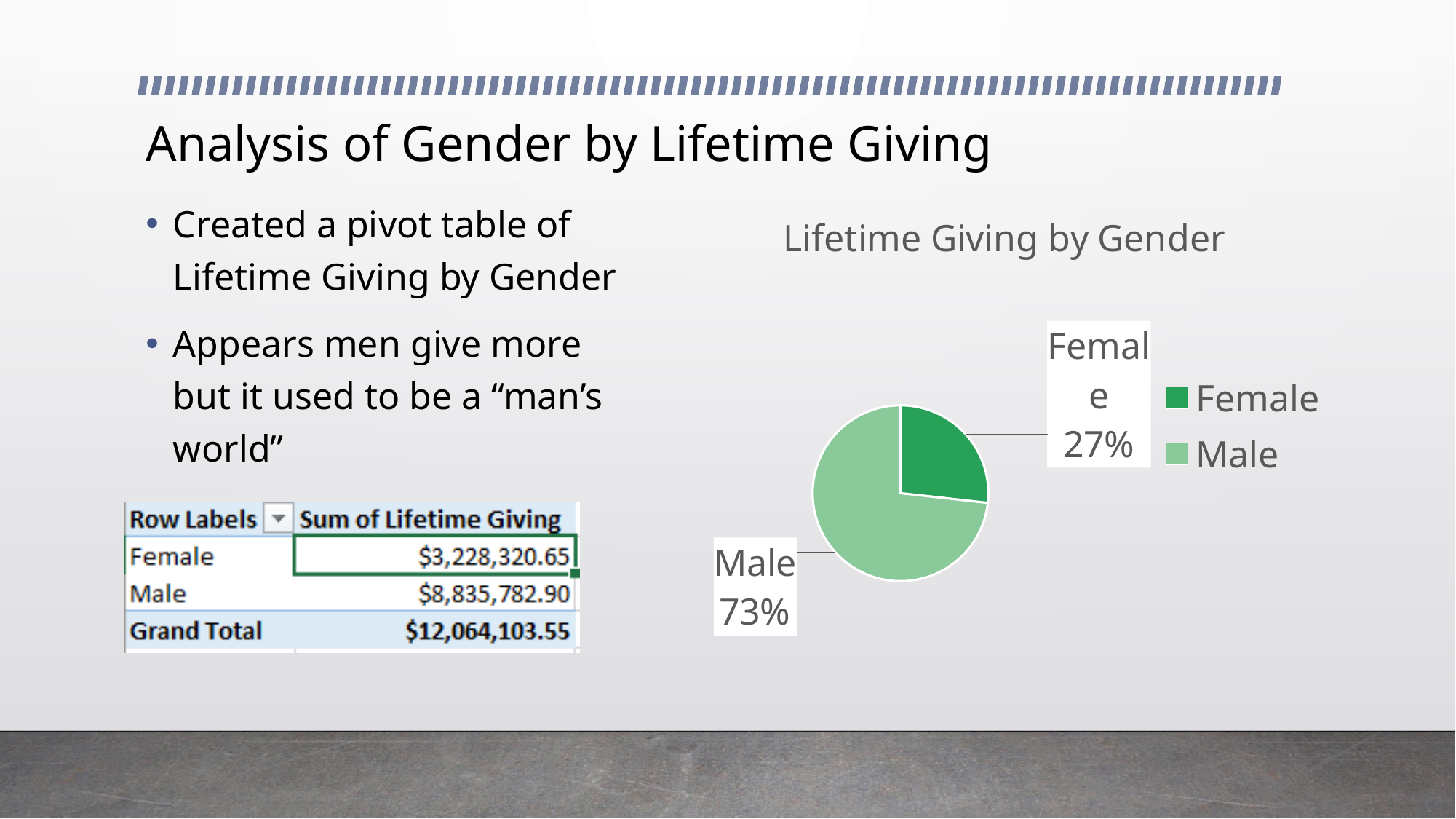
What is the title of the chart on the slide? Lifetime Giving by Gender How many slices does the pie chart have? 2 Which legend entry is shown in the darker green colour in the pie chart? Female What share of the pie does Male represent in the Lifetime Giving by Gender chart? 73% What share of the pie does Female represent in the Lifetime Giving by Gender chart? 27% What kind of chart is shown on the slide? Pie chart How many entries does the legend of the pie chart list? 2 Which slice is larger in the pie chart, Female or Male? Male Is the Female share of the pie chart greater or less than 50%? less Which slice of the pie chart is the largest? Male What is the difference in percentage points between the Male and Female slices of the pie chart? 46 percentage points Which slice of the pie chart is the smallest? Female